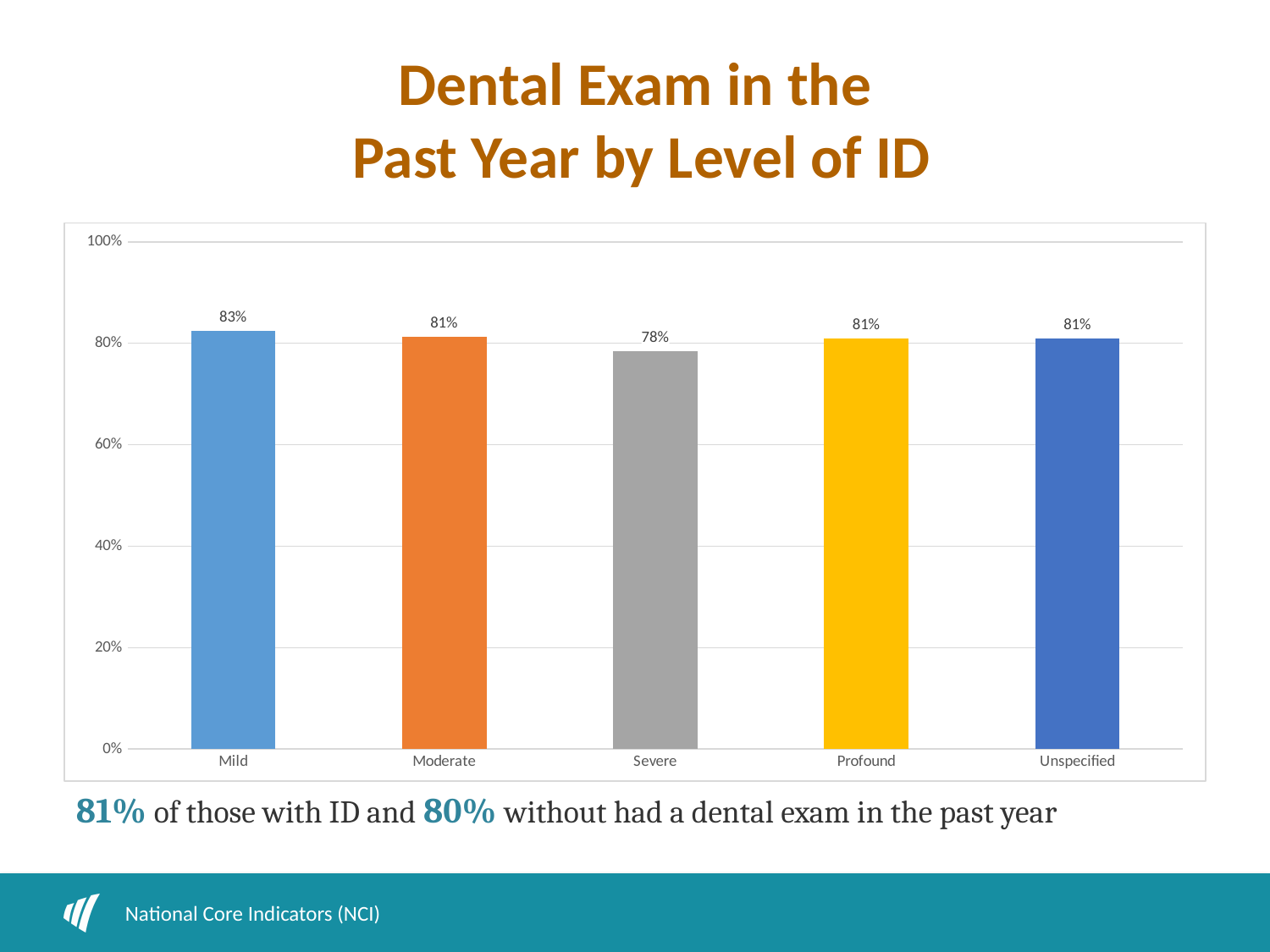
What is the difference between the values for Moderate and Severe? 3% What is the value for Unspecified? 81% Which level of ID has the highest value? Mild What is the difference between the values for Mild and Severe? 5% How many levels of ID are shown on the x axis? 5 What is the value for Profound? 81% What is the value for Severe? 78% Which level of ID has the lowest value? Severe What kind of chart is shown on the slide? bar chart Is the value for Severe greater or less than 80%? less Which is larger, the value for Mild or the value for Moderate? Mild What is the value for Mild? 83%